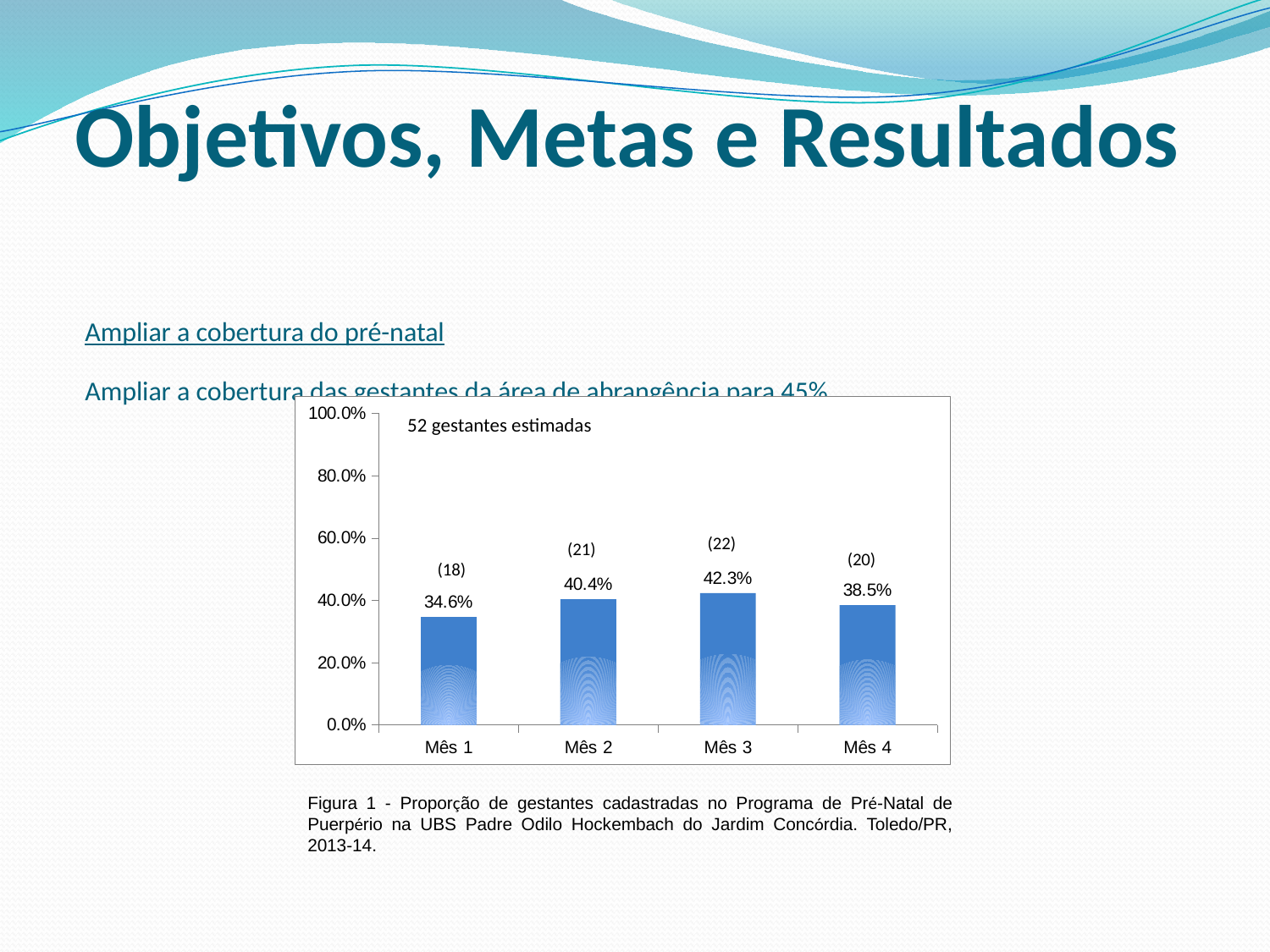
Which month has the lowest value? Mês 1 What is the value for Mês 4? 38.5% Is the value for Mês 2 greater or less than 60%? less Which month has the highest value? Mês 3 What is the difference between the values for Mês 3 and Mês 1? 7.7% What text is shown inside the chart area at the top left? 52 gestantes estimadas What kind of chart is shown? bar chart What is the value for Mês 1? 34.6% Which is larger, the value for Mês 2 or the value for Mês 4? Mês 2 What number of pregnant women is shown in parentheses above the bar for Mês 2? 21 What is the value for Mês 3? 42.3% How many months are shown on the x axis? 4